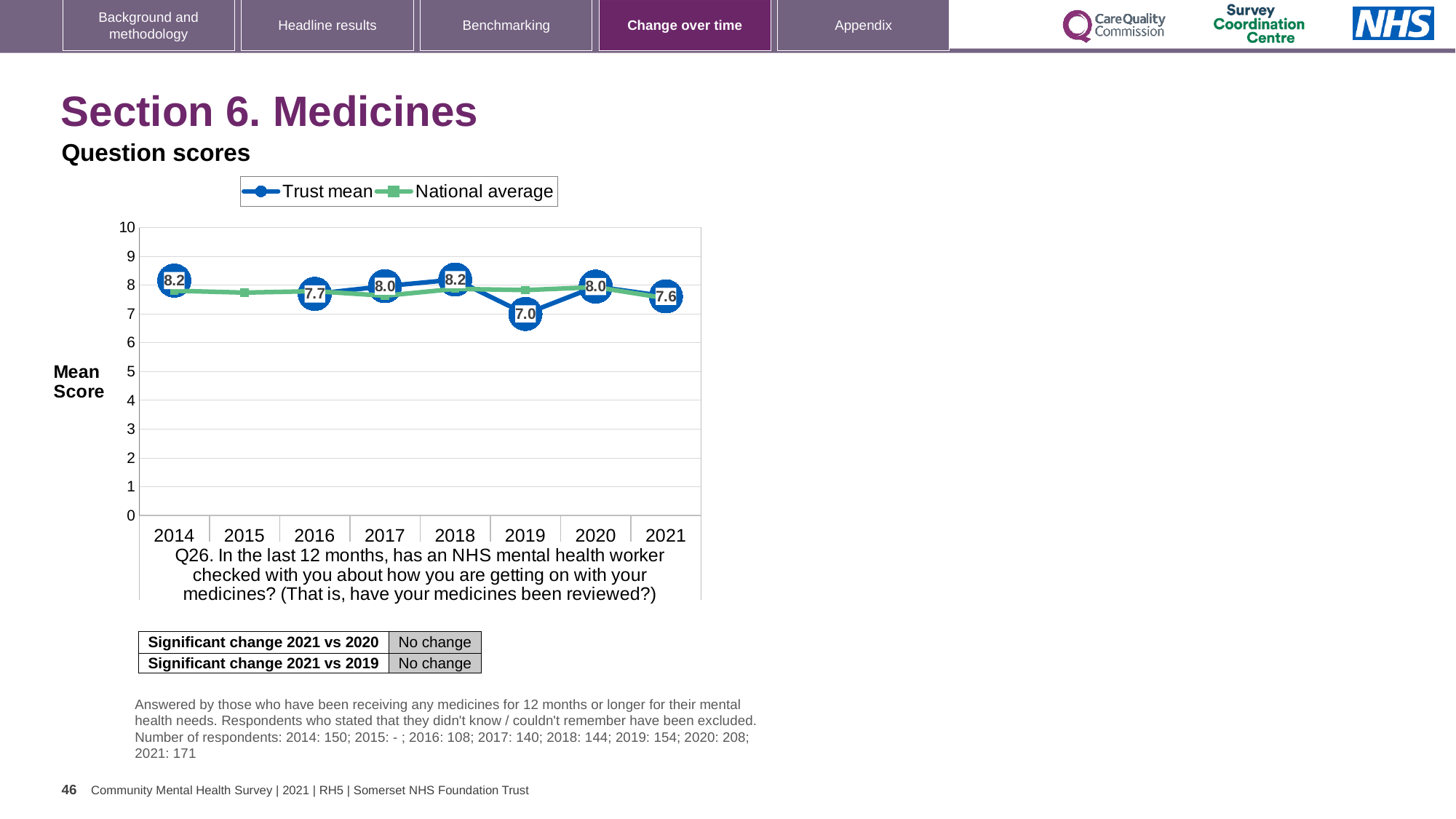
How many years are shown on the x axis? 8 What is the Trust mean score for 2021? 7.6 Is the National average value for 2015 greater or less than 5? greater What is the Trust mean score for 2016? 7.7 What is the difference between the Trust mean scores for 2020 and 2021? 0.4 Does the Trust mean rise or fall from 2018 to 2019? Fall How many series does the legend list? 2 What is the Trust mean score for 2019? 7.0 What kind of chart is shown? Line chart What is the Trust mean score for 2014? 8.2 In which year is the Trust mean score lowest? 2019 Which is larger, the Trust mean score for 2018 or for 2019? 2018